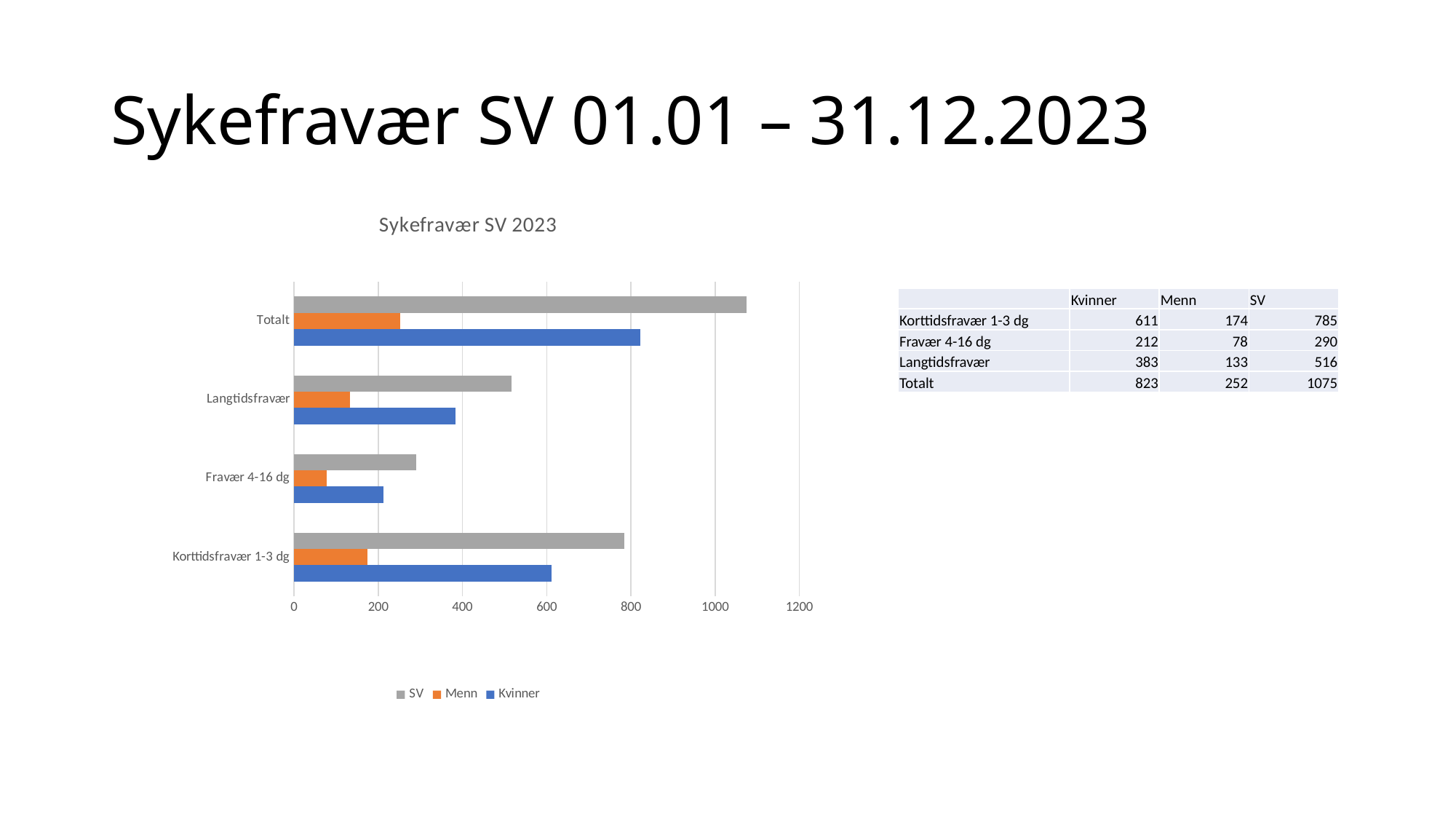
How many series does the chart legend list? 3 What is the title of the chart? Sykefravær SV 2023 Which series is shown in orange in the chart? Menn Using the table values, what is the difference between the Kvinner and Menn values for Totalt? 571 Excluding Totalt, which category has the highest SV value in the chart? Korttidsfravær 1-3 dg What type of chart is shown on the slide? bar chart Is the Kvinner bar for Langtidsfravær greater or less than 400? less According to the table on the slide, what is the Kvinner value for Korttidsfravær 1-3 dg? 611 Which category has the lowest Menn value in the chart? Fravær 4-16 dg Is the SV bar for Totalt greater or less than 1000? greater According to the table on the slide, what is the SV value for Langtidsfravær? 516 How many categories are shown on the chart's vertical axis? 4